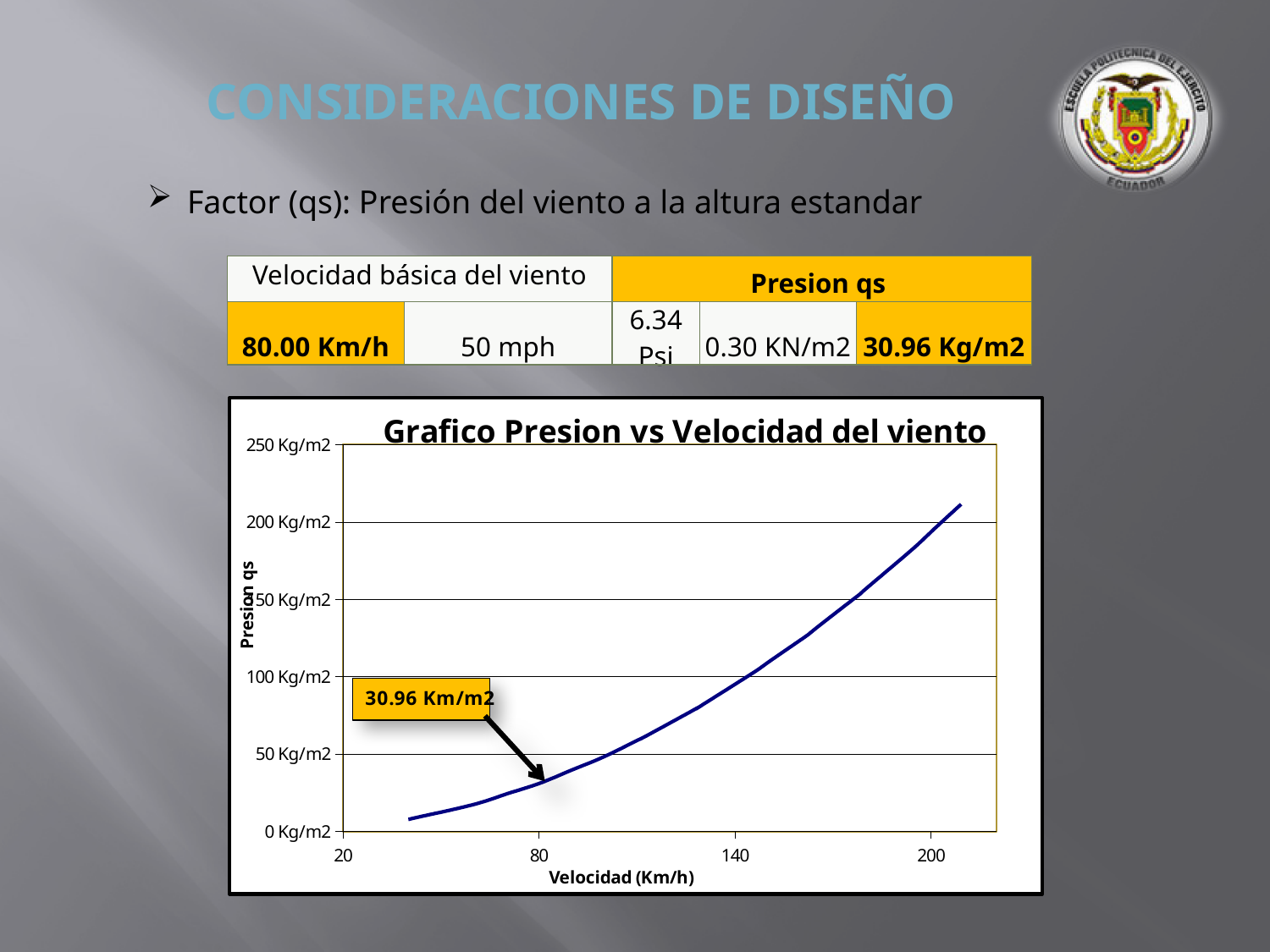
What is the title of the chart? Grafico Presion vs Velocidad del viento What kind of chart is shown on the slide? line chart What is the highest tick value shown on the y axis of the chart? 250 Kg/m2 What value does the callout on the chart give for the pressure at 80 Km/h? 30.96 Km/m2 Is the pressure value at 80 Km/h greater or less than 50 Kg/m2? less Which has the higher pressure on the chart, 80 Km/h or 140 Km/h? 140 Km/h Is the pressure value at 110 Km/h greater or less than 100 Kg/m2? less What is the label of the x axis of the chart? Velocidad (Km/h) How many tick labels are shown on the x axis of the chart? 4 Do the values on the chart rise or fall as velocity increases along the x axis? rise Is the pressure value at 200 Km/h greater or less than 150 Kg/m2? greater